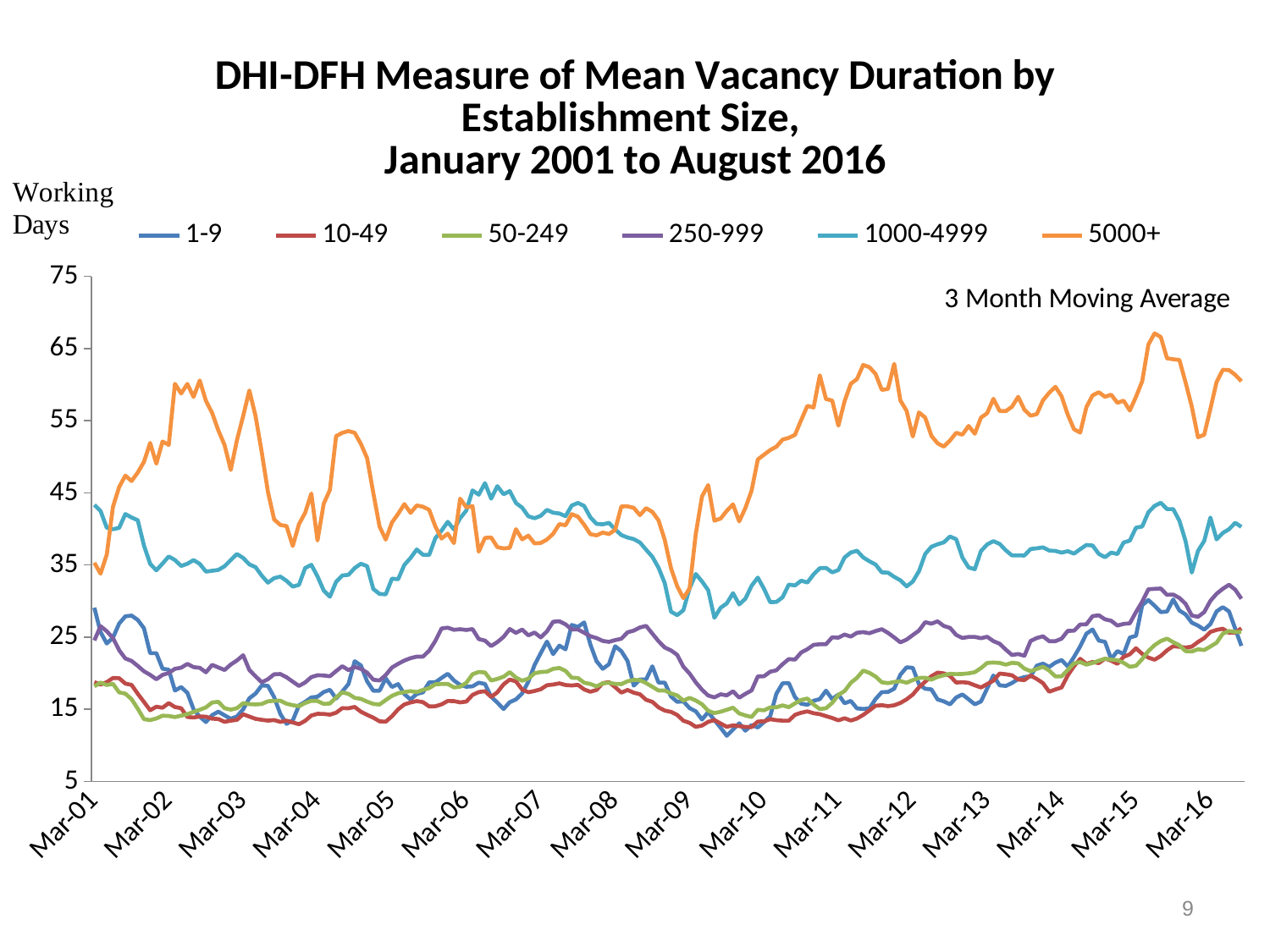
Is the value for the 1000-4999 series at Mar-09 greater or less than 35? less At Mar-16, which series is larger: 1000-4999 or 250-999? 1000-4999 How many series does the legend list? 6 Is the value for the 5000+ series at Mar-16 greater or less than 45? greater Is the value for the 10-49 series at Mar-02 greater or less than 25? less What kind of chart is shown on the slide? line chart What unit is shown on the vertical axis label? Working Days How many year labels are shown on the x axis? 16 Which series has the highest values at Mar-16? 5000+ What are the establishment size categories listed in the legend? 1-9, 10-49, 50-249, 250-999, 1000-4999, 5000+ Does the 5000+ series rise or fall between Mar-09 and Mar-11? rise